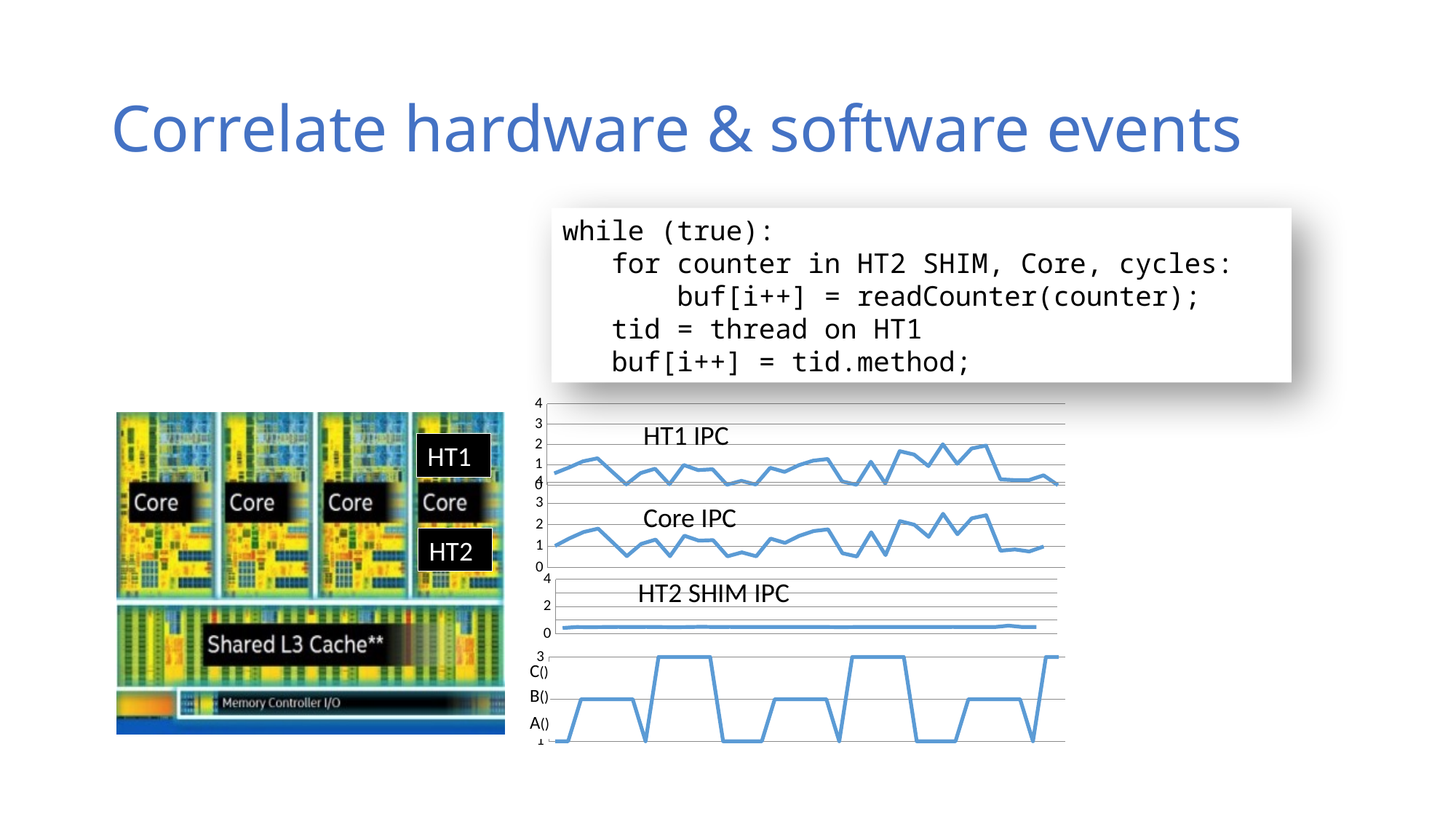
What are the three labels on the y axis of the bottom chart? A(), B(), C() In the HT1 IPC chart, is the highest plotted value greater or less than 3? less What is the maximum value shown on the y axis of the Core IPC chart? 4 In the Core IPC chart, is the highest plotted value greater or less than 3? less How many charts are stacked on the right side of the slide? 4 What kind of chart is the HT2 SHIM IPC chart? line chart In the HT2 SHIM IPC chart, are the plotted values greater or less than 1? less Does the line in the HT2 SHIM IPC chart rise, fall, or stay roughly flat along the x axis? stays roughly flat What is the title of the second chart from the top on the right side of the slide? Core IPC What kind of chart is the HT1 IPC chart? line chart